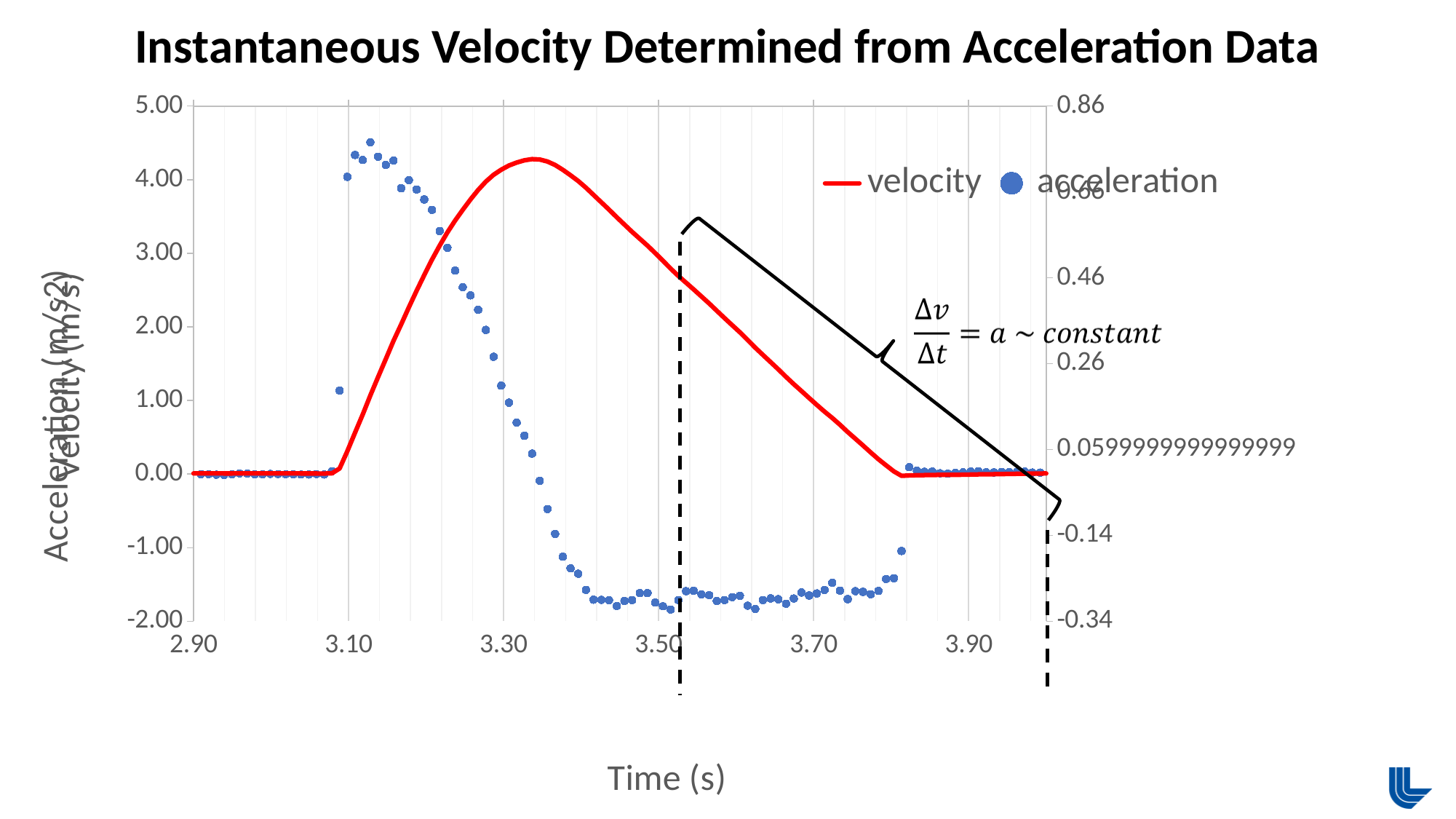
How many series does the chart legend list? 2 What is the highest tick value shown on the left y axis? 5.00 What is the label of the x axis? Time (s) What colour is the velocity series drawn in? Red Does the velocity line rise or fall between 3.50 s and 3.80 s? fall Do the acceleration points rise or fall between 3.20 s and 3.40 s? fall Does the velocity line rise or fall between 3.10 s and 3.30 s? rise On the left axis, is the acceleration value at about 3.00 s greater or less than 1.00? less On the left axis, is the acceleration value at about 3.60 s greater or less than -1.00? less On the left axis, is the acceleration value at about 3.12 s greater or less than 4.00? greater